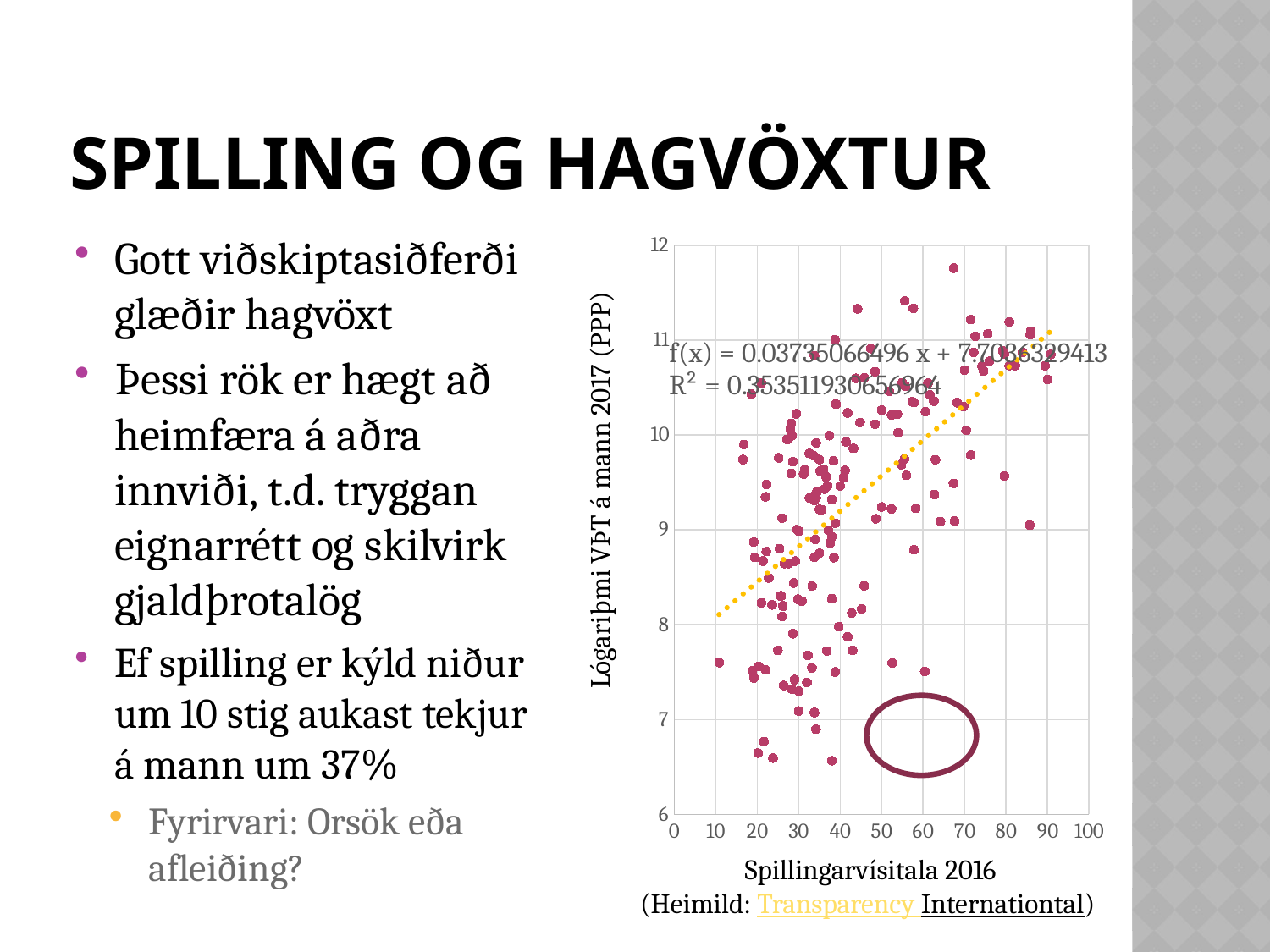
What is the title of the x axis of the chart? Spillingarvísitala 2016 What is the title of the y axis of the chart? Lógariþmi VÞT á mann 2017 (PPP) Does the dotted trendline in the chart slope upward or downward? Upward What kind of chart is shown on the slide? Scatter chart Is the y value of the highest plotted point greater or less than 11.5? greater Is the y value of the lowest plotted point greater or less than 7? less Is the y value of the highest plotted point greater or less than 12? less Do the plotted values generally rise or fall as the Spillingarvísitala 2016 increases along the x axis? Rise